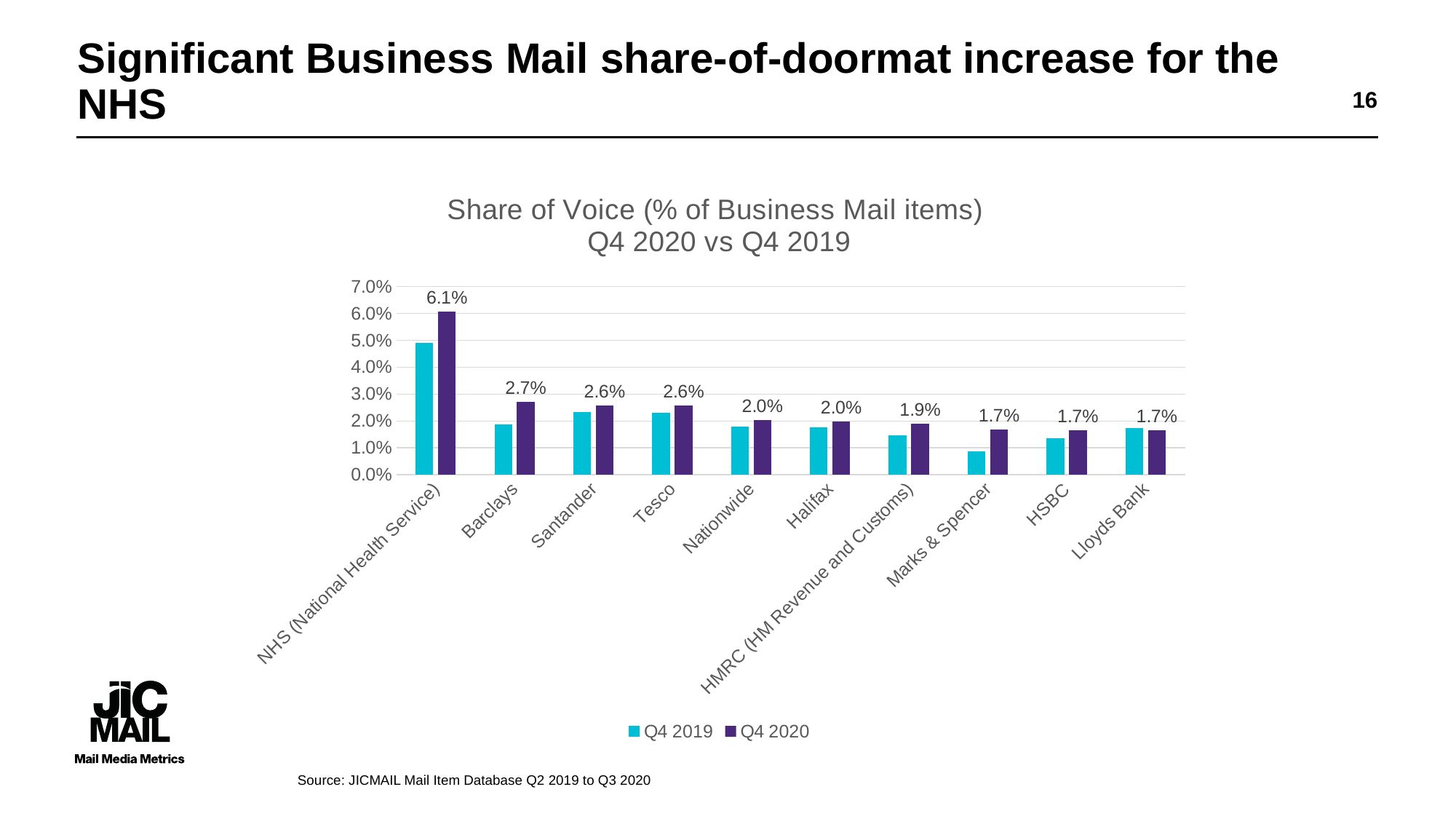
How many organisations are shown on the x axis? 10 Is the Q4 2019 value for Marks & Spencer greater or less than 1.0%? less What is the Q4 2020 value for Barclays? 2.7% Which organisation has the lowest Q4 2019 share of voice? Marks & Spencer What kind of chart is shown on the slide? Bar chart What is the difference between the Q4 2020 values for NHS (National Health Service) and Barclays? 3.4% Which organisation has the highest Q4 2020 share of voice? NHS (National Health Service) For Marks & Spencer, which is larger: the Q4 2019 value or the Q4 2020 value? Q4 2020 How many series does the legend list? 2 What is the Q4 2020 value for HMRC (HM Revenue and Customs)? 1.9% Is the Q4 2019 value for NHS (National Health Service) greater or less than 4.0%? greater What is the Q4 2020 share of voice for NHS (National Health Service)? 6.1%